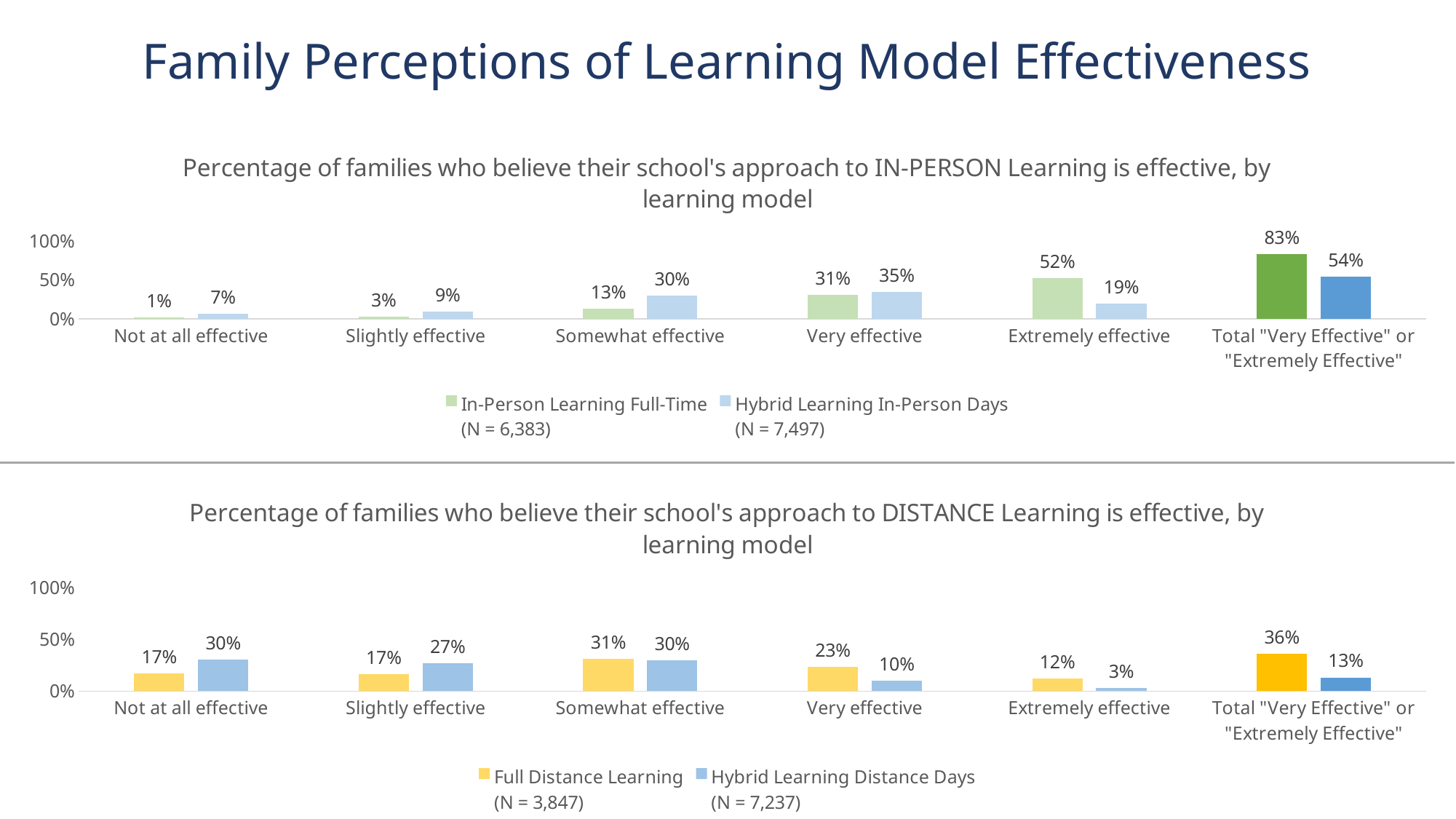
In the DISTANCE Learning chart, what is the Hybrid Learning Distance Days value for "Extremely effective"? 3% How many categories are shown on the x axis of the DISTANCE Learning chart? 6 In the IN-PERSON Learning chart, which category has the highest value for In-Person Learning Full-Time? Total "Very Effective" or "Extremely Effective" In the DISTANCE Learning chart, what is the difference between the Full Distance Learning and Hybrid Learning Distance Days values for "Very effective"? 13% In the DISTANCE Learning chart, which is larger for "Not at all effective": Full Distance Learning or Hybrid Learning Distance Days? Hybrid Learning Distance Days In the IN-PERSON Learning chart, what percentage of In-Person Learning Full-Time families rated the approach "Extremely effective"? 52% In the DISTANCE Learning chart, which category has the lowest value for Hybrid Learning Distance Days? Extremely effective What kind of chart is the DISTANCE Learning chart? Bar chart In the IN-PERSON Learning chart, what is the Hybrid Learning In-Person Days value for "Somewhat effective"? 30% In the DISTANCE Learning chart, what percentage of Full Distance Learning families rated the approach "Very effective"? 23% How many series does the legend of the IN-PERSON Learning chart list? 2 In the IN-PERSON Learning chart, what is the difference between the In-Person Learning Full-Time and Hybrid Learning In-Person Days values for the Total "Very Effective" or "Extremely Effective" category? 29%